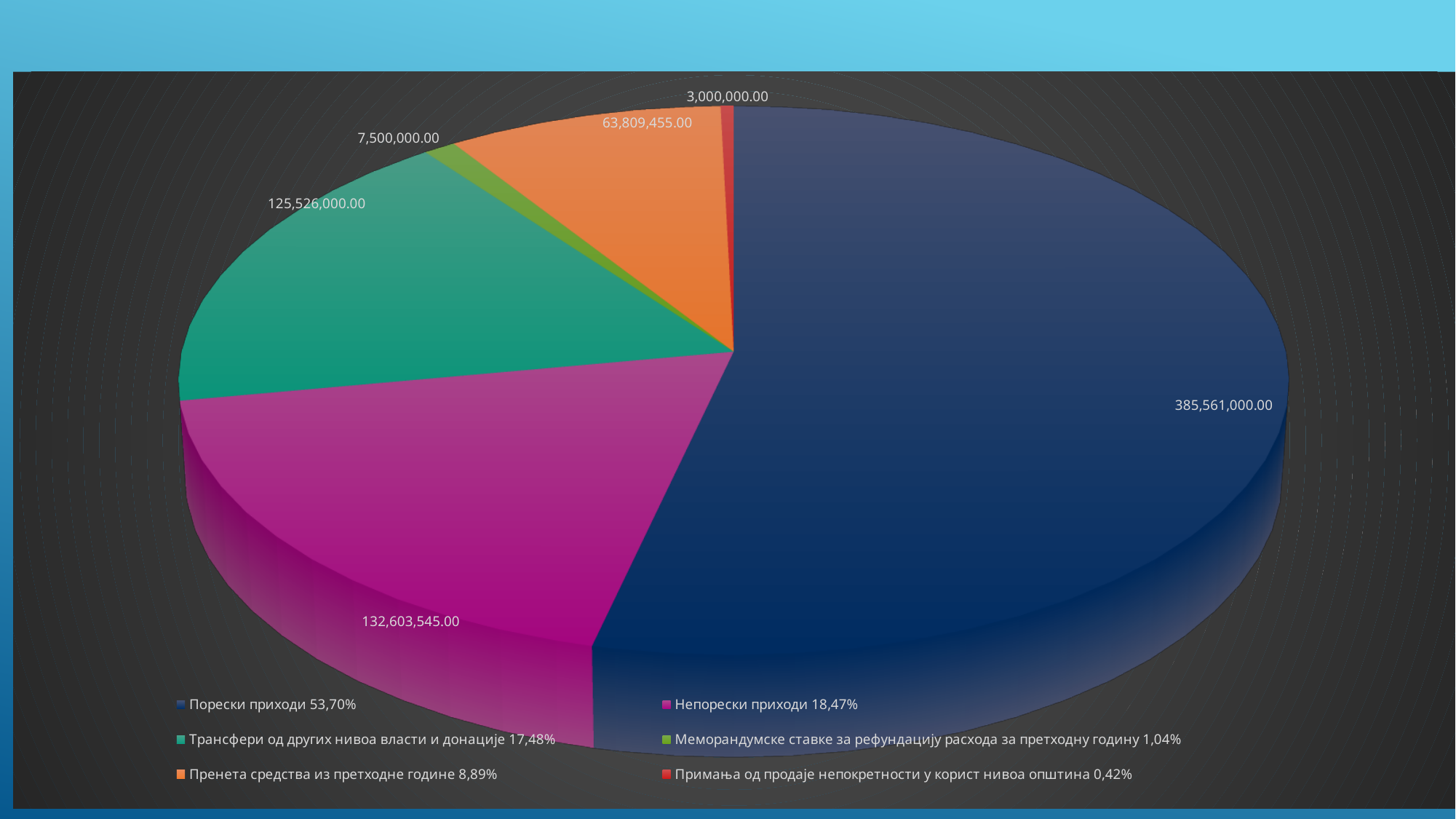
How many slices does the pie chart have? 6 Which is larger: the Непорески приходи slice or the Трансфери од других нивоа власти и донације slice? Непорески приходи What share of the pie does Трансфери од других нивоа власти и донације represent, according to the legend? 17,48% What is the value of the Порески приходи slice? 385,561,000.00 What kind of chart is shown on the slide? pie chart What is the value of the Непорески приходи slice? 132,603,545.00 What is the value of the Пренета средства из претходне године slice? 63,809,455.00 What is the difference between the Порески приходи value and the Непорески приходи value? 252,957,455.00 What colour is the Пренета средства из претходне године slice? orange Which category has the largest slice of the pie? Порески приходи What share of the pie does Меморандумске ставке за рефундацију расхода за претходну годину represent, according to the legend? 1,04% Which category has the smallest slice of the pie? Примања од продаје непокретности у корист нивоа општина